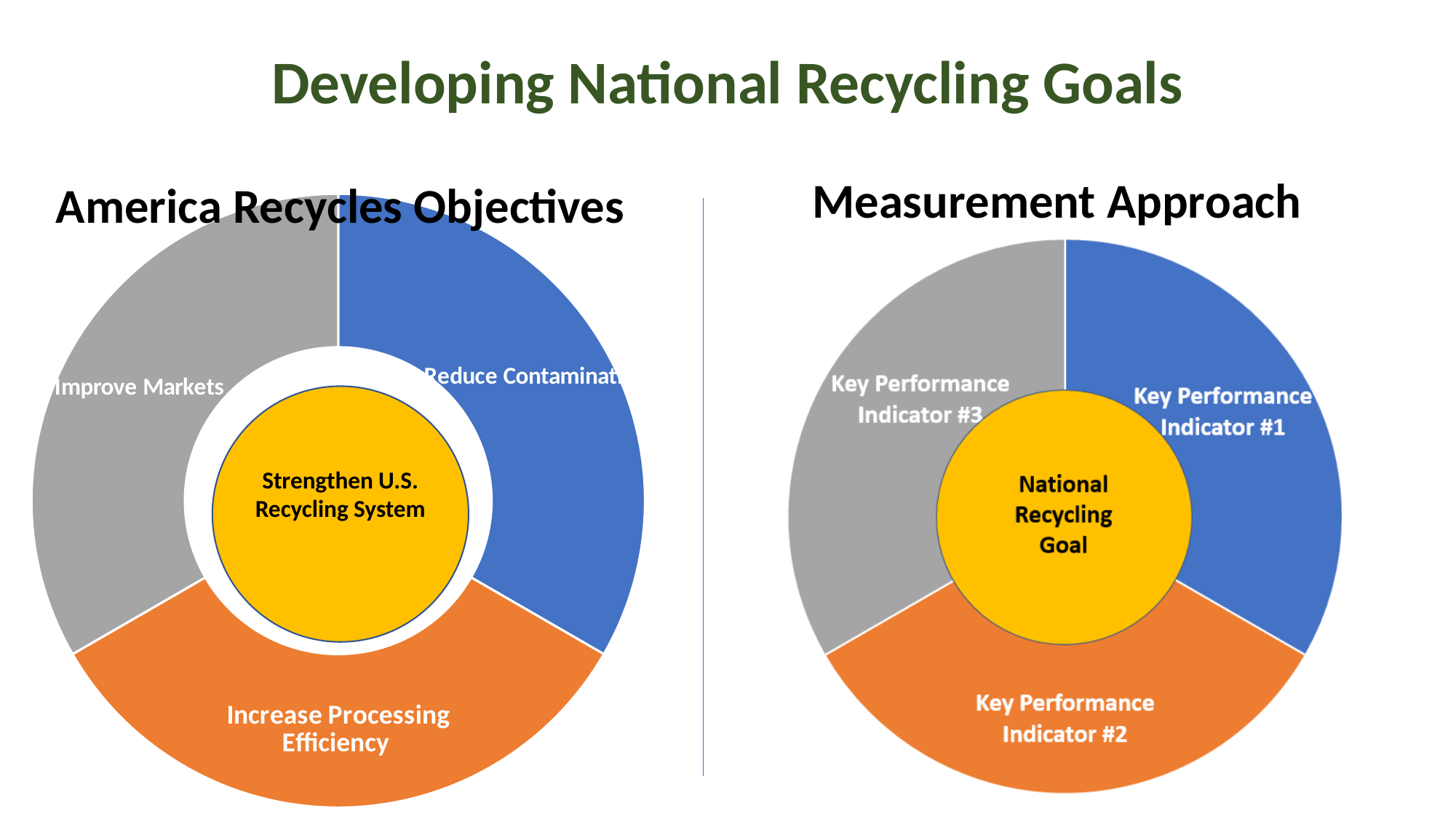
On the left chart (America Recycles Objectives), how many segments does the ring have? 3 On the right chart (Measurement Approach), which segment is orange? Key Performance Indicator #2 On the left chart (America Recycles Objectives), what label is in the centre circle? Strengthen U.S. Recycling System On the left chart (America Recycles Objectives), which segment is labelled at the bottom in orange? Increase Processing Efficiency On the right chart (Measurement Approach), which segment is grey? Key Performance Indicator #3 On the right chart (Measurement Approach), what label is in the centre circle? National Recycling Goal On the left chart (America Recycles Objectives), which segment is grey? Improve Markets How many charts are shown on the slide? 2 What kind of chart is the America Recycles Objectives chart on the left? Doughnut chart What kind of chart is the Measurement Approach chart on the right? Doughnut chart On the right chart (Measurement Approach), which segment is blue? Key Performance Indicator #1 On the right chart (Measurement Approach), how many segments does the ring have? 3